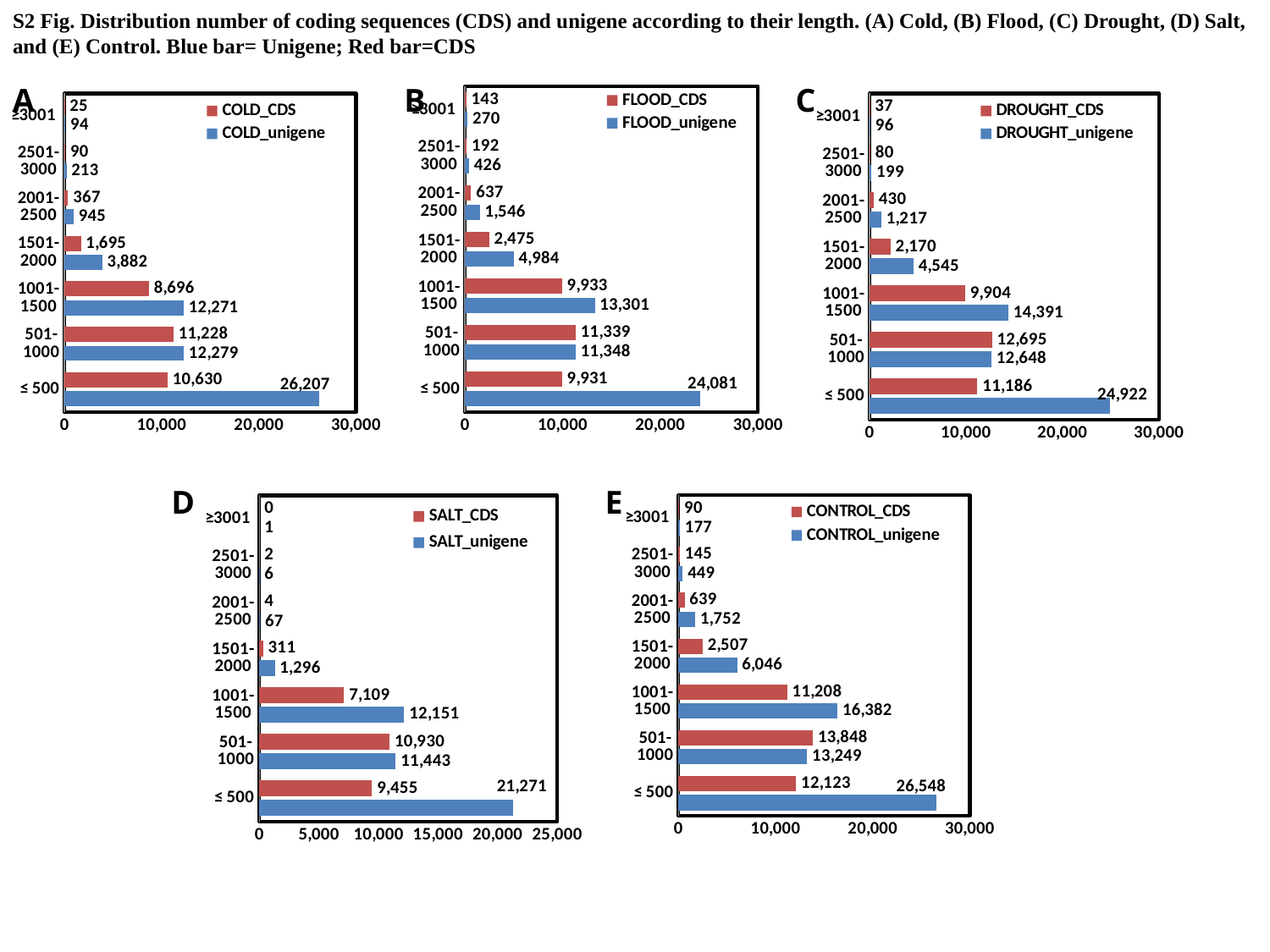
In chart B (FLOOD), what is the FLOOD_CDS value for the 1501-2000 length category? 2,475 In chart C (DROUGHT), which length category has the highest DROUGHT_CDS value? 501-1000 In chart A (COLD), what is the COLD_unigene value for the ≤ 500 length category? 26,207 What type of chart is chart A (COLD)? bar chart In chart B (FLOOD), what are the two legend entries? FLOOD_CDS and FLOOD_unigene In chart D (SALT), what is the SALT_CDS value for the 1001-1500 length category? 7,109 In chart E (CONTROL), what is the difference between the CONTROL_unigene and CONTROL_CDS values for the ≤ 500 category? 14,425 In chart A (COLD), for the 1001-1500 category, which is larger: COLD_CDS or COLD_unigene? COLD_unigene In chart D (SALT), how many length categories are shown on the y axis? 7 In chart D (SALT), which length category has the lowest SALT_unigene value? ≥3001 In chart C (DROUGHT), is the DROUGHT_unigene value for ≤ 500 greater or less than 20,000? greater In chart E (CONTROL), how many series does the legend list? 2